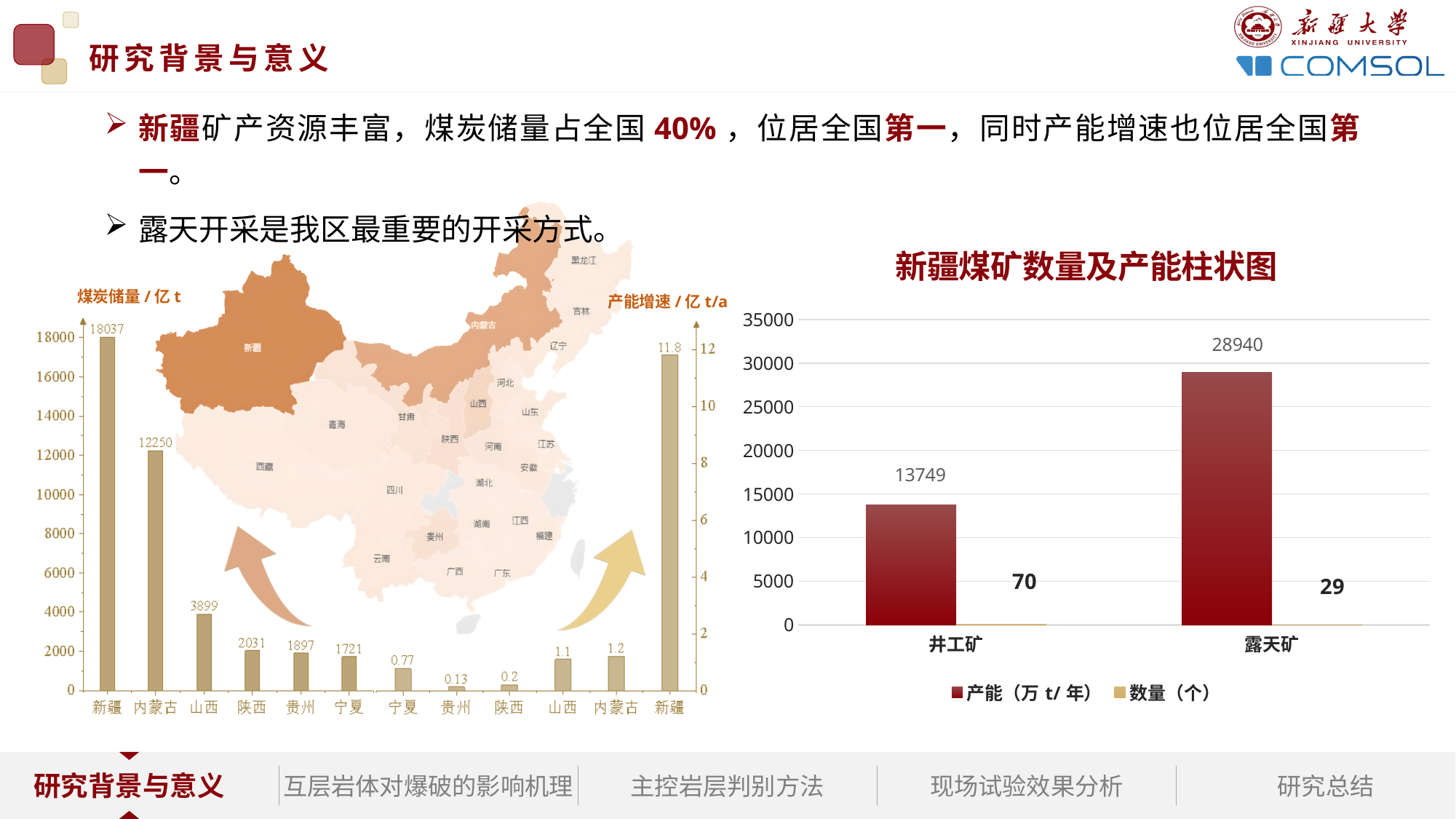
In the left chart, what is the 煤炭储量 value for 新疆? 18037 In the left chart, is the 煤炭储量 value for 山西 greater or less than 4000? less In the left chart, what is the 产能增速 value for 内蒙古? 1.2 In the chart titled 新疆煤矿数量及产能柱状图, what is the 数量 value for 井工矿? 70 In the chart titled 新疆煤矿数量及产能柱状图, what is the 产能 value for 露天矿? 28940 In the chart titled 新疆煤矿数量及产能柱状图, what is the total 数量 of 井工矿 and 露天矿 combined? 99 In the chart titled 新疆煤矿数量及产能柱状图, which category has the higher 产能, 井工矿 or 露天矿? 露天矿 In the left chart, what is the difference in 煤炭储量 between 新疆 and 内蒙古? 5787 In the chart titled 新疆煤矿数量及产能柱状图, how many series does the legend list? 2 In the left chart, which province has the lowest 产能增速? 贵州 In the chart titled 新疆煤矿数量及产能柱状图, what kind of chart is shown? bar chart In the chart titled 新疆煤矿数量及产能柱状图, what is the difference in 产能 between 露天矿 and 井工矿? 15191